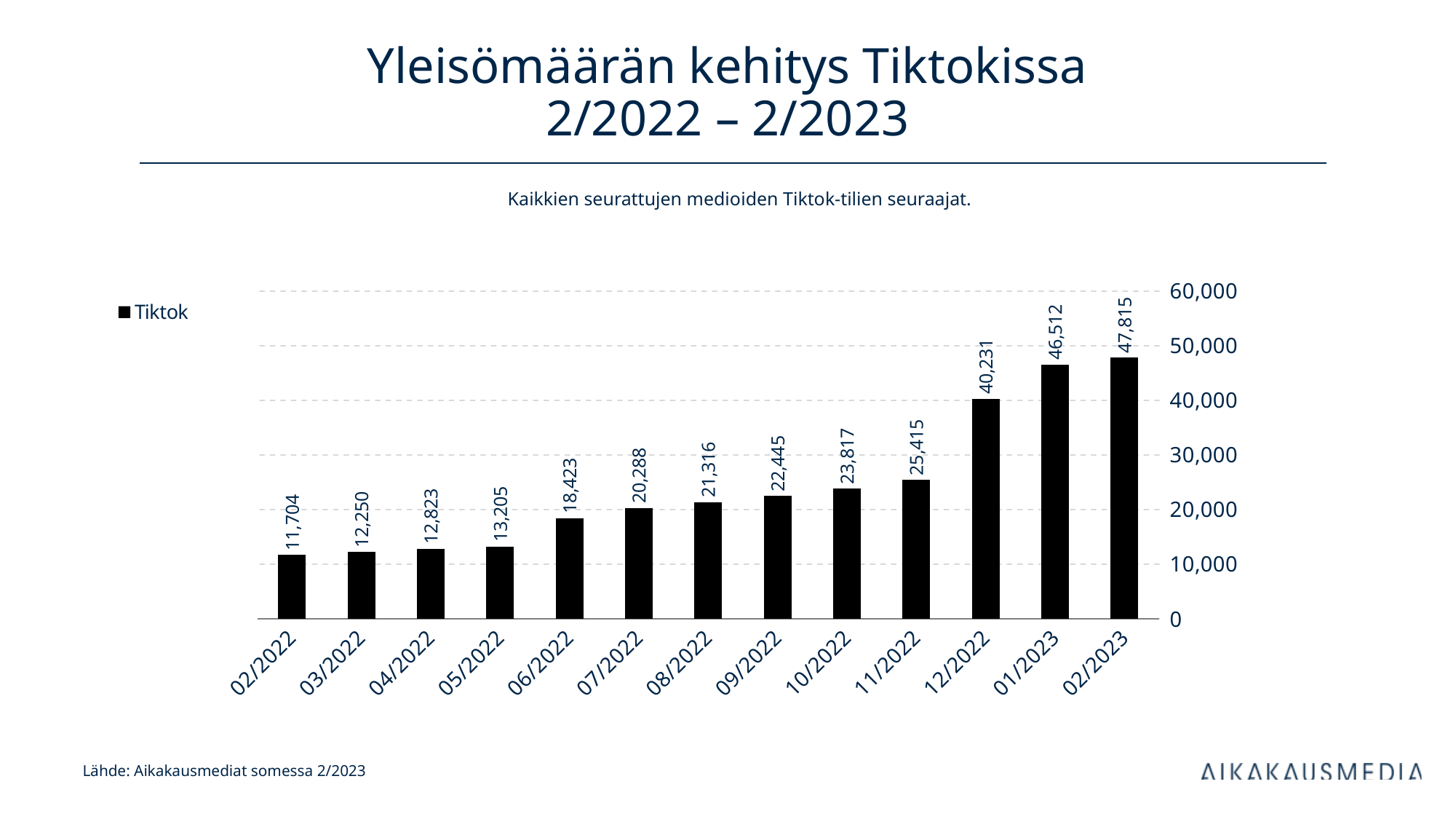
What is the value for 07/2022? 20,288 What is the value for 02/2022? 11,704 How many months are shown on the x axis? 13 How many series does the legend list? 1 What is the difference between the values for 02/2023 and 01/2023? 1,303 Which is larger, the value for 09/2022 or the value for 10/2022? 10/2022 Which month has the highest value? 02/2023 What is the difference between the values for 12/2022 and 11/2022? 14,816 What is the value for 12/2022? 40,231 Do the values rise or fall from 02/2022 to 02/2023? rise Which month has the lowest value? 02/2022 What kind of chart is shown on the slide? bar chart